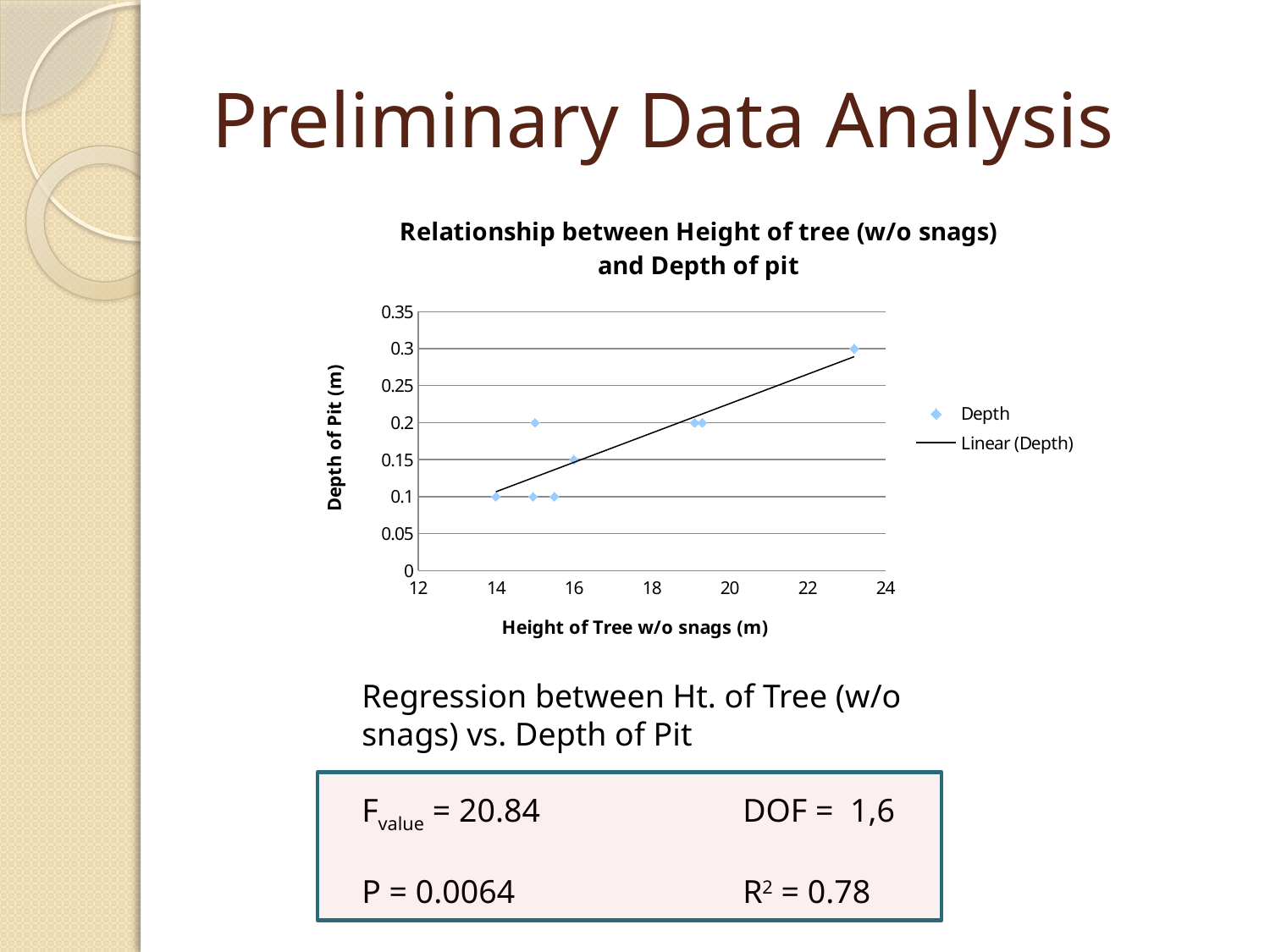
What is the highest Depth of Pit value plotted in the chart? 0.3 Is the Depth of Pit for the point at a tree height of about 23 m greater or less than 0.25? greater What is the label of the x axis of the chart? Height of Tree w/o snags (m) Which has a larger Depth of Pit: the point at a tree height of about 23 m or the point at 14 m? The point at about 23 m How many entries does the chart legend list? 2 Is the trendline value at a tree height of 14 m greater or less than 0.15? less What is the lowest Depth of Pit value plotted in the chart? 0.1 Does Depth of Pit generally rise or fall as Height of Tree increases along the x axis? Rise What kind of chart is shown on the slide? Scatter chart What is the title of the chart? Relationship between Height of tree (w/o snags) and Depth of pit What is the Depth of Pit for the point at a tree height of 16 m? 0.15 How many data points are plotted in the chart? 8